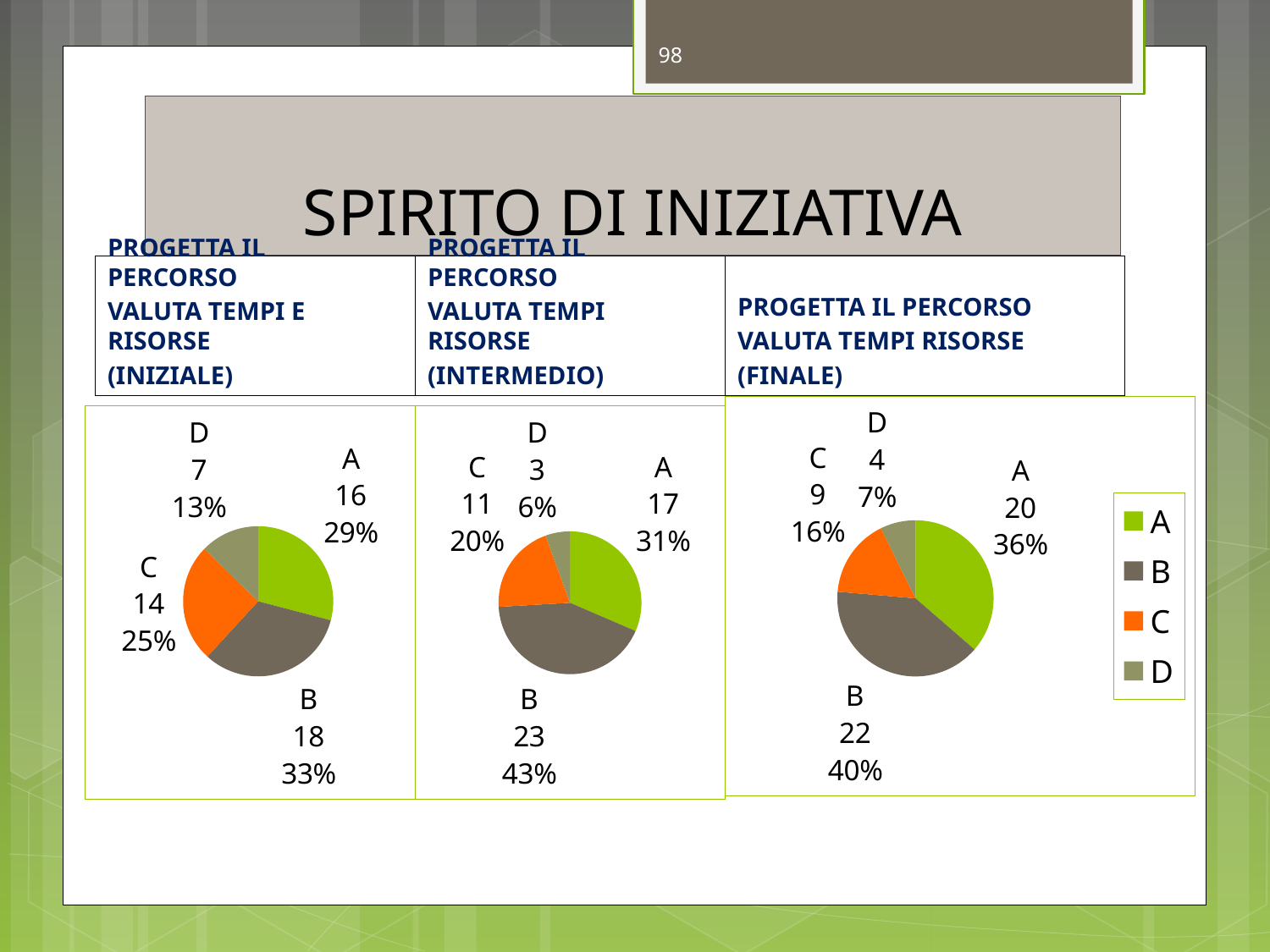
In the right pie chart (FINALE), which category has the smallest share? D In the middle pie chart (INTERMEDIO), what percentage share does category A have? 31% In the middle pie chart (INTERMEDIO), what is the value for category D? 3 What type of chart is used for the three charts on the slide? Pie chart In the left pie chart (INIZIALE), what percentage share does category C have? 25% How many categories does each pie chart on the slide show? 4 In the left pie chart (INIZIALE), what is the value for category B? 18 In the right pie chart (FINALE), what is the difference between the values for B and A? 2 In the legend on the right of the slide, which colour represents category C? Orange In the middle pie chart (INTERMEDIO), which category has the largest share? B In the right pie chart (FINALE), what is the value for category C? 9 In the left pie chart (INIZIALE), which is larger, the value for A or the value for C? A